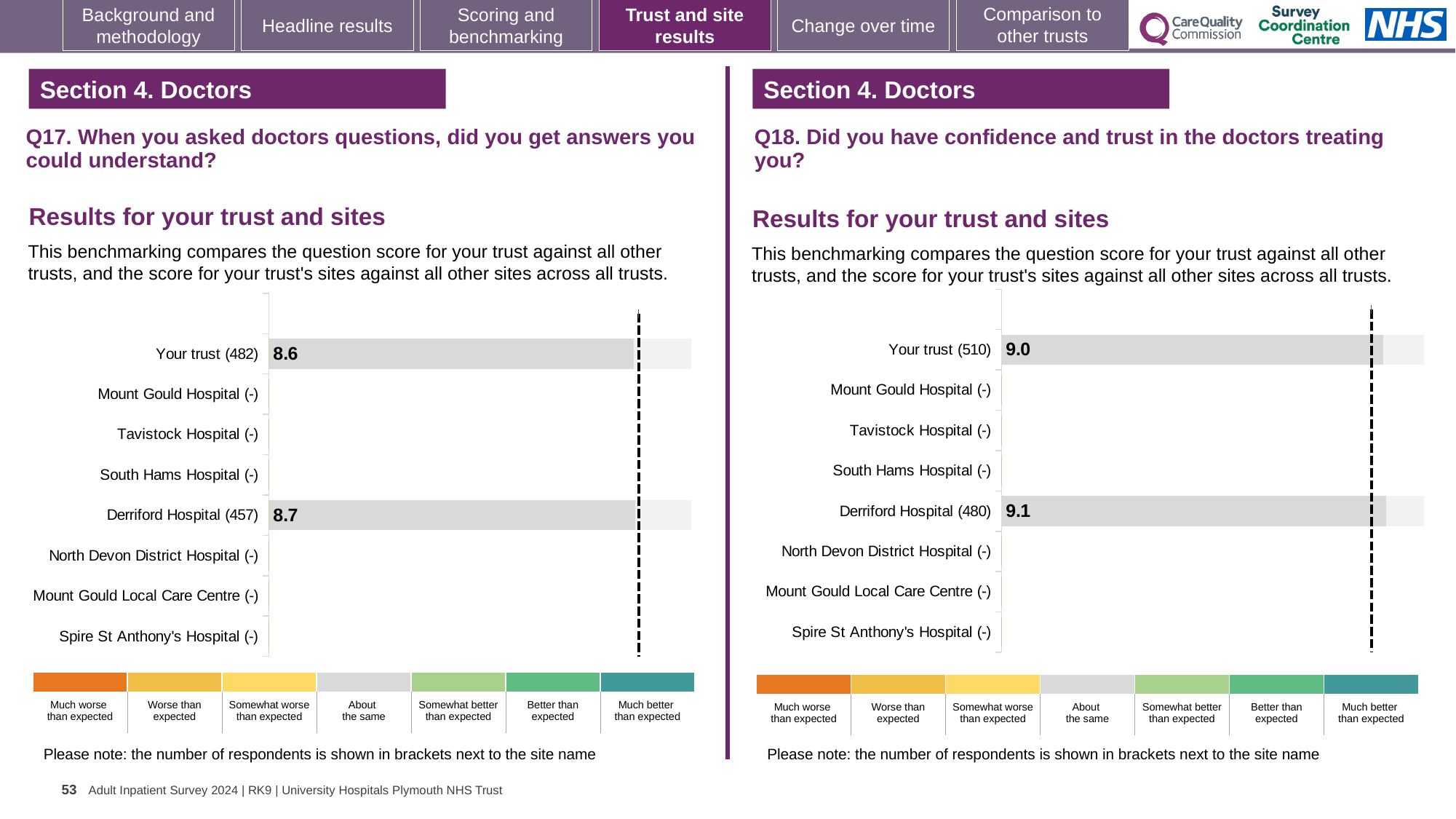
In the Q17 chart on the left, what is the score for Derriford Hospital (457)? 8.7 How many benchmark categories does the colour key below the Q17 chart on the left show? 7 What kind of chart is the Q18 chart on the right? Bar chart In the Q18 chart on the right, what is the score for Your trust (510)? 9.0 How many site/trust categories are listed on the y axis of the Q18 chart on the right? 8 In the Q17 chart on the left, what is the score for Your trust (482)? 8.6 How many respondents are shown in brackets for Derriford Hospital in the Q18 chart on the right? 480 In the Q17 chart on the left, how many categories have a plotted bar with a score? 2 In the Q17 chart on the left, which has the lower score, Your trust (482) or Derriford Hospital (457)? Your trust (482) In the Q17 chart on the left, what is the difference between the Derriford Hospital score and the Your trust score? 0.1 In the Q18 chart on the right, what is the score for Derriford Hospital (480)? 9.1 In the Q18 chart on the right, which has the higher score, Your trust (510) or Derriford Hospital (480)? Derriford Hospital (480)